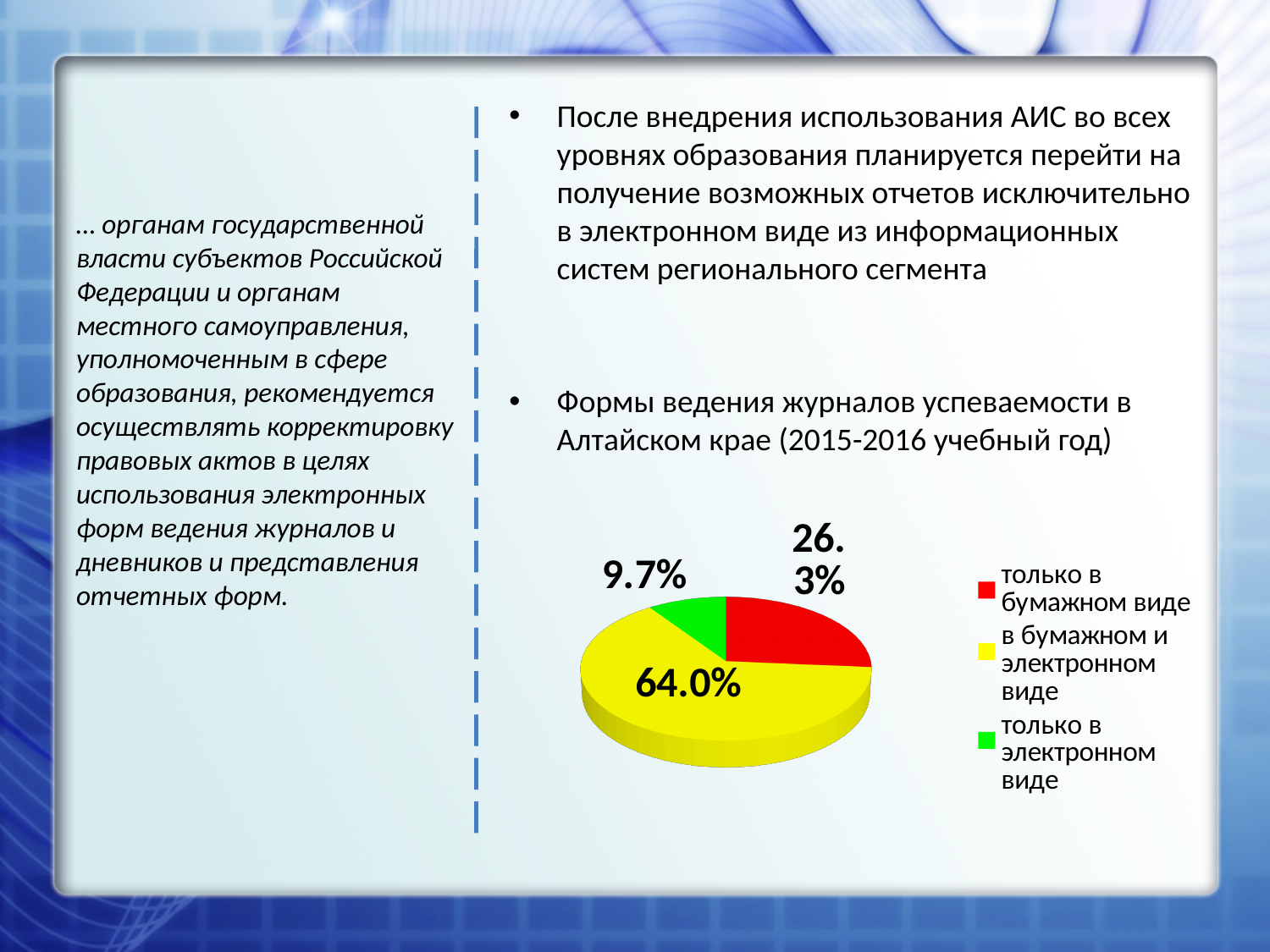
How many entries does the legend list? 3 What colour is the slice for "только в бумажном виде"? red How many slices does the pie chart have? 3 Which is larger: the share for "только в бумажном виде" or the share for "только в электронном виде"? только в бумажном виде What kind of chart is shown on the slide? pie chart What share of the pie is labelled "в бумажном и электронном виде"? 64.0% What share of the pie is labelled "только в бумажном виде"? 26.3% Which category has the smallest slice of the pie? только в электронном виде What colour is the slice for "только в электронном виде"? green Which category has the largest slice of the pie? в бумажном и электронном виде What share of the pie is labelled "только в электронном виде"? 9.7% What is the difference in percentage points between "в бумажном и электронном виде" and "только в бумажном виде"? 37.7